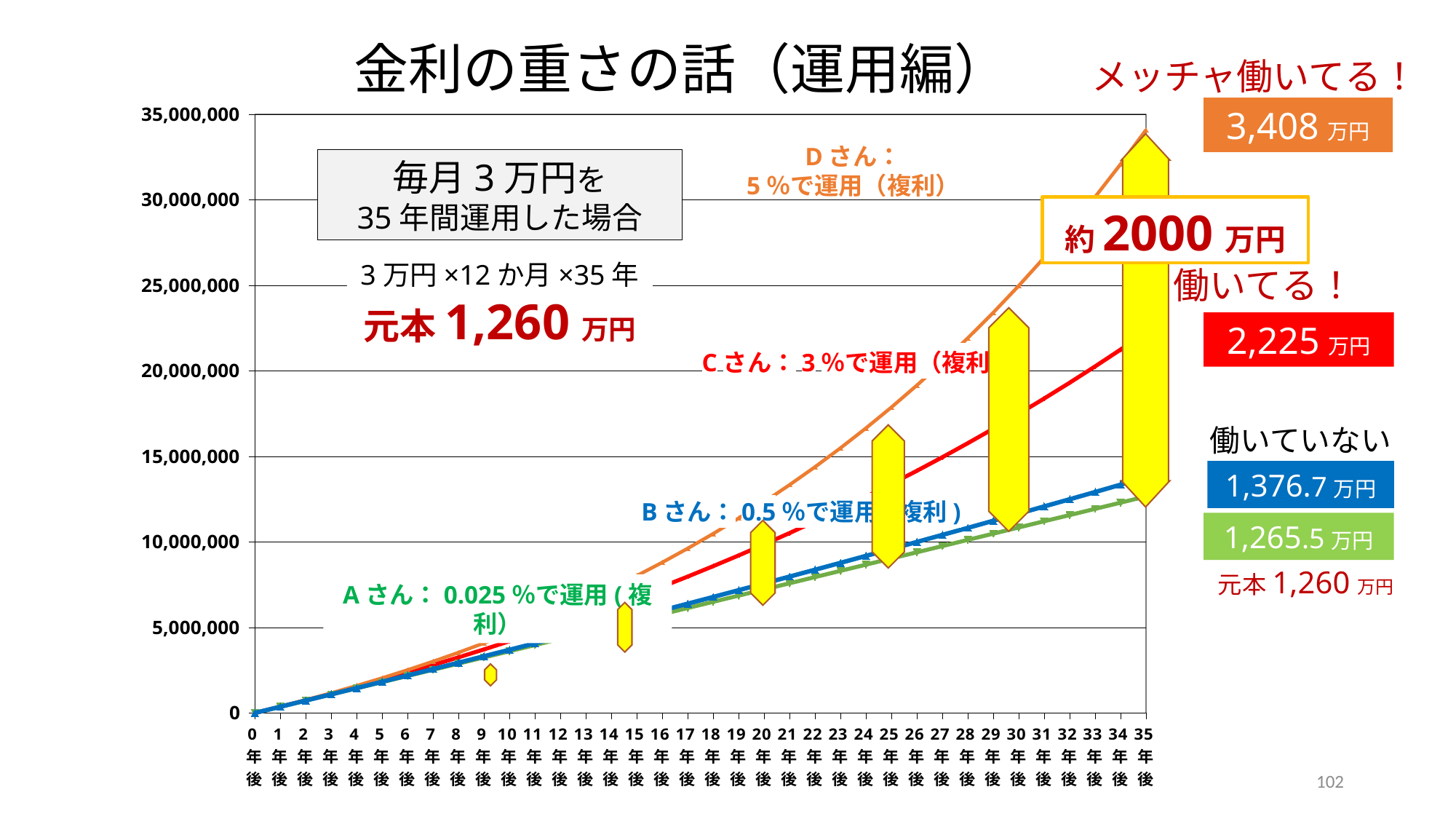
What is the final amount shown for Bさん (0.5% compound)? 1,376.7万円 What is the final amount shown for Dさん (5% compound)? 3,408万円 Which series has the highest value at 35年後? Dさん（5％で運用） What is the title of the slide's chart? 金利の重さの話（運用編） Do the plotted values rise or fall as the years increase along the x axis? rise Which series has the lowest value at 35年後? Aさん（0.025％で運用） What kind of chart is shown on the slide? line chart What is the final amount shown for Cさん (3% compound)? 2,225万円 How many series (people A–D) are plotted on the chart? 4 What is the final amount shown for Aさん (0.025% compound)? 1,265.5万円 Is the value for Dさん at 35年後 greater or less than 30,000,000? greater What is the difference between the final amounts of Dさん and Cさん? 1,183万円